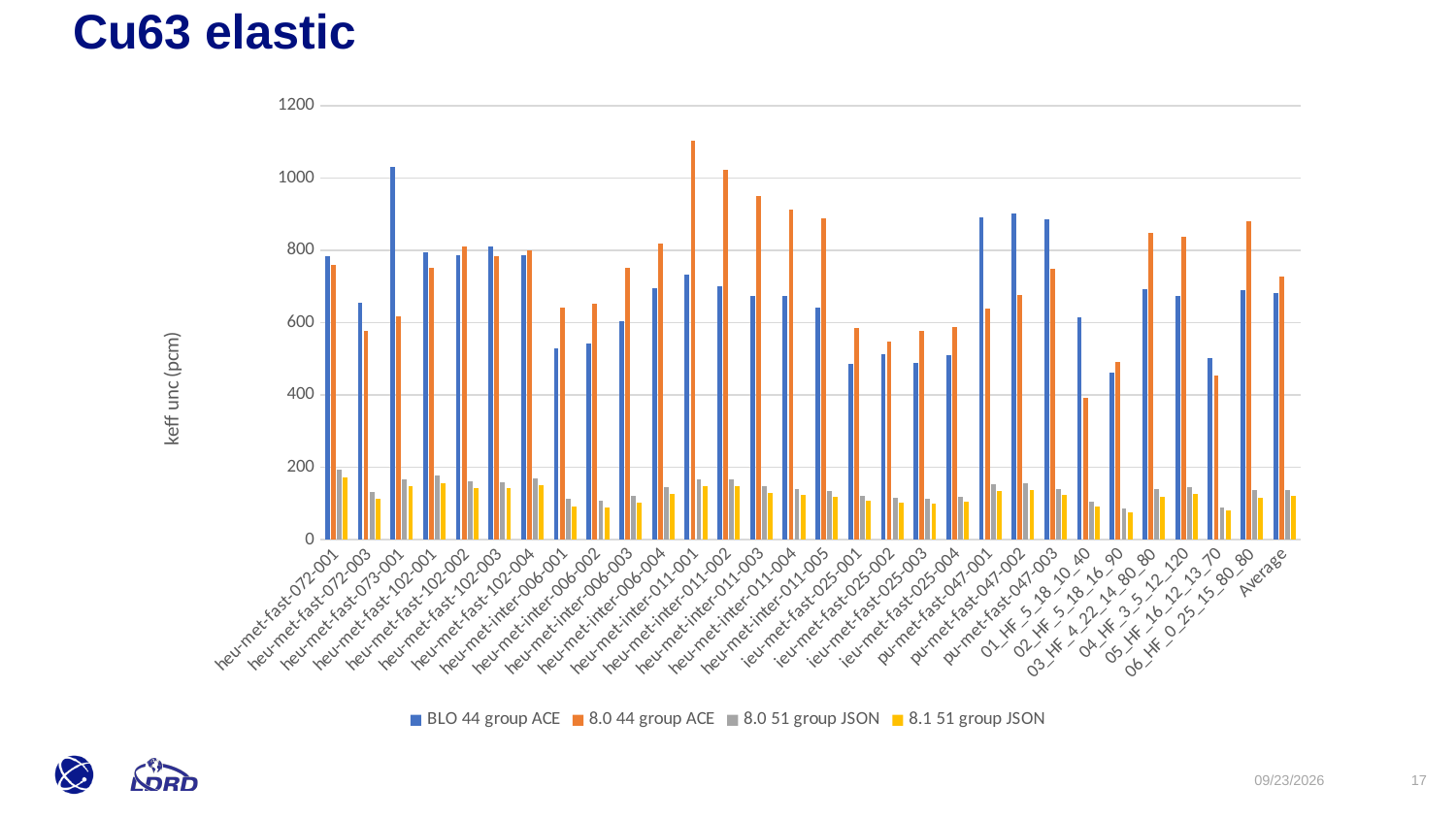
For pu-met-fast-047-001, which is larger: the BLO 44 group ACE value or the 8.0 44 group ACE value? BLO 44 group ACE What is the title of the slide? Cu63 elastic How many categories are shown along the x axis? 30 What kind of chart is shown on the slide? bar chart For which category is the 8.0 44 group ACE value highest? heu-met-inter-011-001 Is the 8.1 51 group JSON value for Average greater or less than 200? less For which category is the BLO 44 group ACE value highest? heu-met-fast-073-001 How many series does the legend list? 4 Is the BLO 44 group ACE value for heu-met-fast-073-001 greater or less than 1000? greater What is the y-axis title of the chart? keff unc (pcm) For heu-met-inter-011-001, which is larger: the BLO 44 group ACE value or the 8.0 44 group ACE value? 8.0 44 group ACE Is the 8.0 44 group ACE value for heu-met-inter-011-001 greater or less than 1000? greater